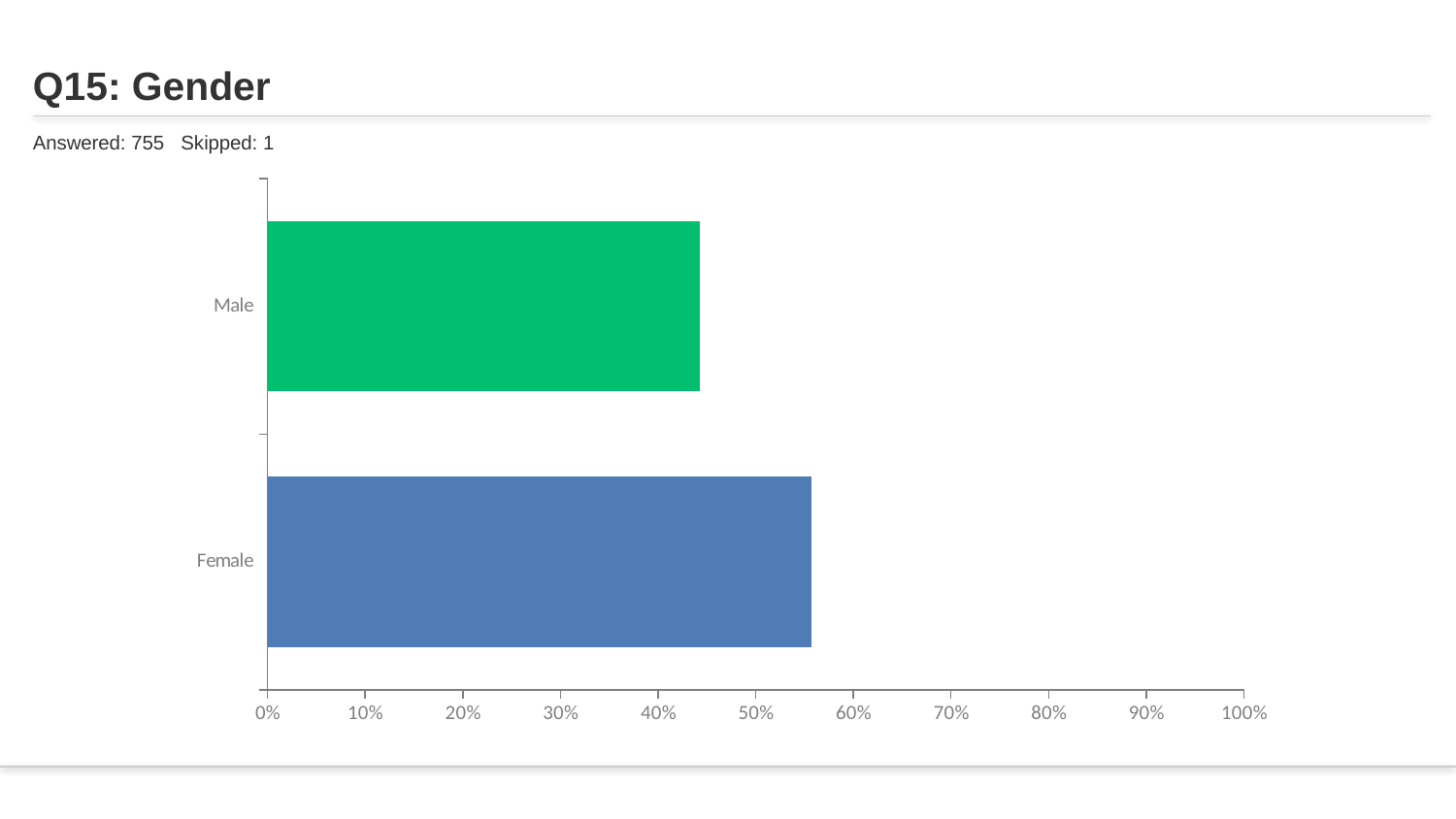
How many categories are plotted in the chart? 2 Which category has the lowest value? Male How many respondents answered the question shown in the chart? 755 Is the value for Male greater or less than 50%? less Is the value for Male greater or less than 40%? greater Which category has the highest value? Female What kind of chart is shown on the slide? bar chart Which is larger, the value for Male or the value for Female? Female What is the title of the chart? Q15: Gender Is the value for Female greater or less than 50%? greater